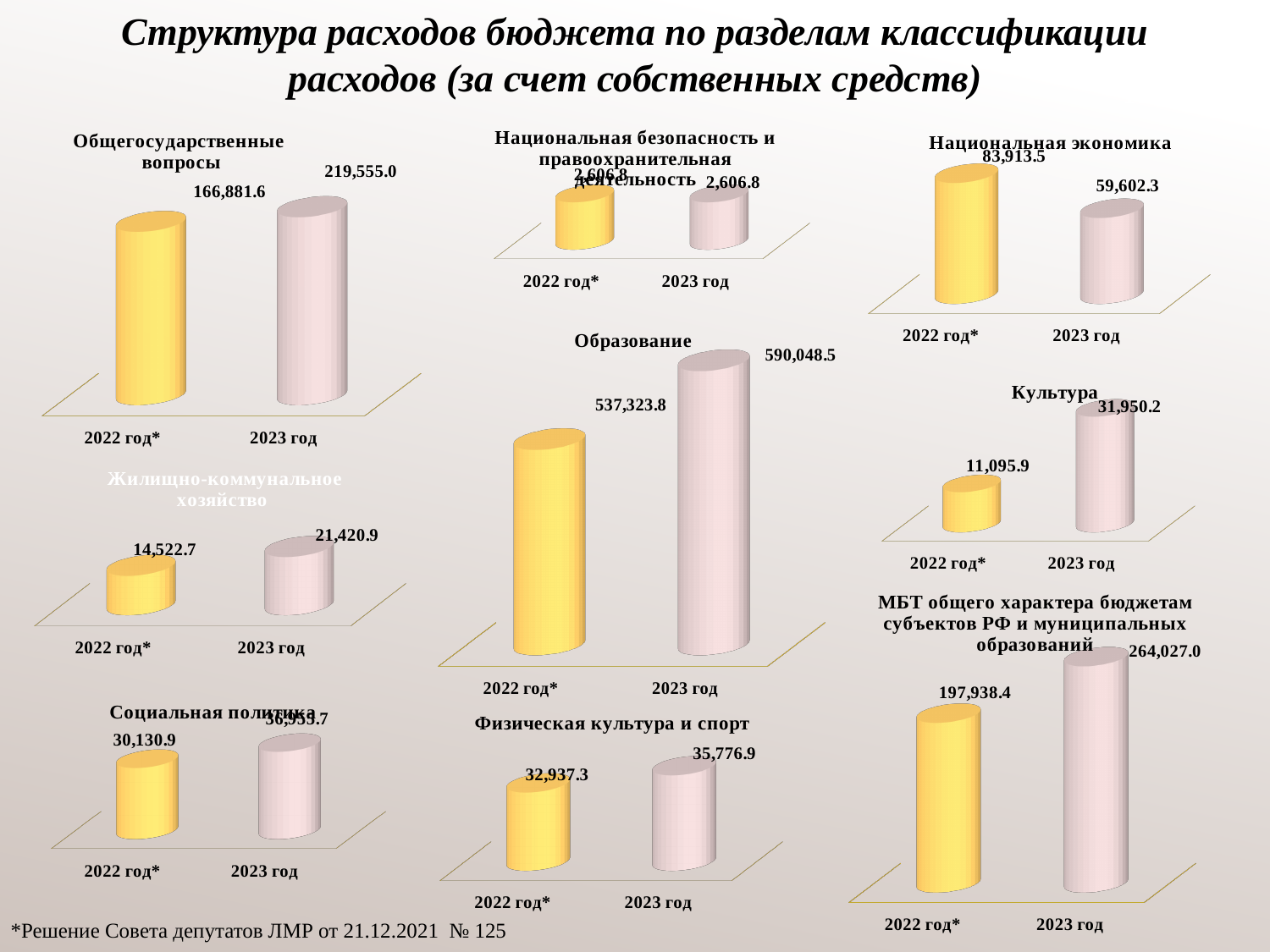
In the 'Образование' chart, what is the value for 2022 год*? 537,323.8 In the 'Культура' chart, which year has the lower value? 2022 год* In the 'Национальная экономика' chart, do the values rise or fall from 2022 год* to 2023 год? fall How many bars are plotted in the 'Культура' chart? 2 In the 'МБТ общего характера бюджетам субъектов РФ и муниципальных образований' chart, what is the difference between the 2023 год and 2022 год* values? 66,088.6 In the 'Физическая культура и спорт' chart, is the value for 2023 год larger or smaller than the value for 2022 год*? larger What type of chart is used for 'Образование'? bar chart In the 'Общегосударственные вопросы' chart, what is the value for 2023 год? 219,555.0 In the 'Образование' chart, what is the difference between the 2023 год and 2022 год* values? 52,724.7 In the 'Национальная экономика' chart, which year has the higher value? 2022 год* In the 'Национальная безопасность и правоохранительная деятельность' chart, what is the value for 2023 год? 2,606.8 In the 'Жилищно-коммунальное хозяйство' chart, what is the difference between the 2023 год and 2022 год* values? 6,898.2